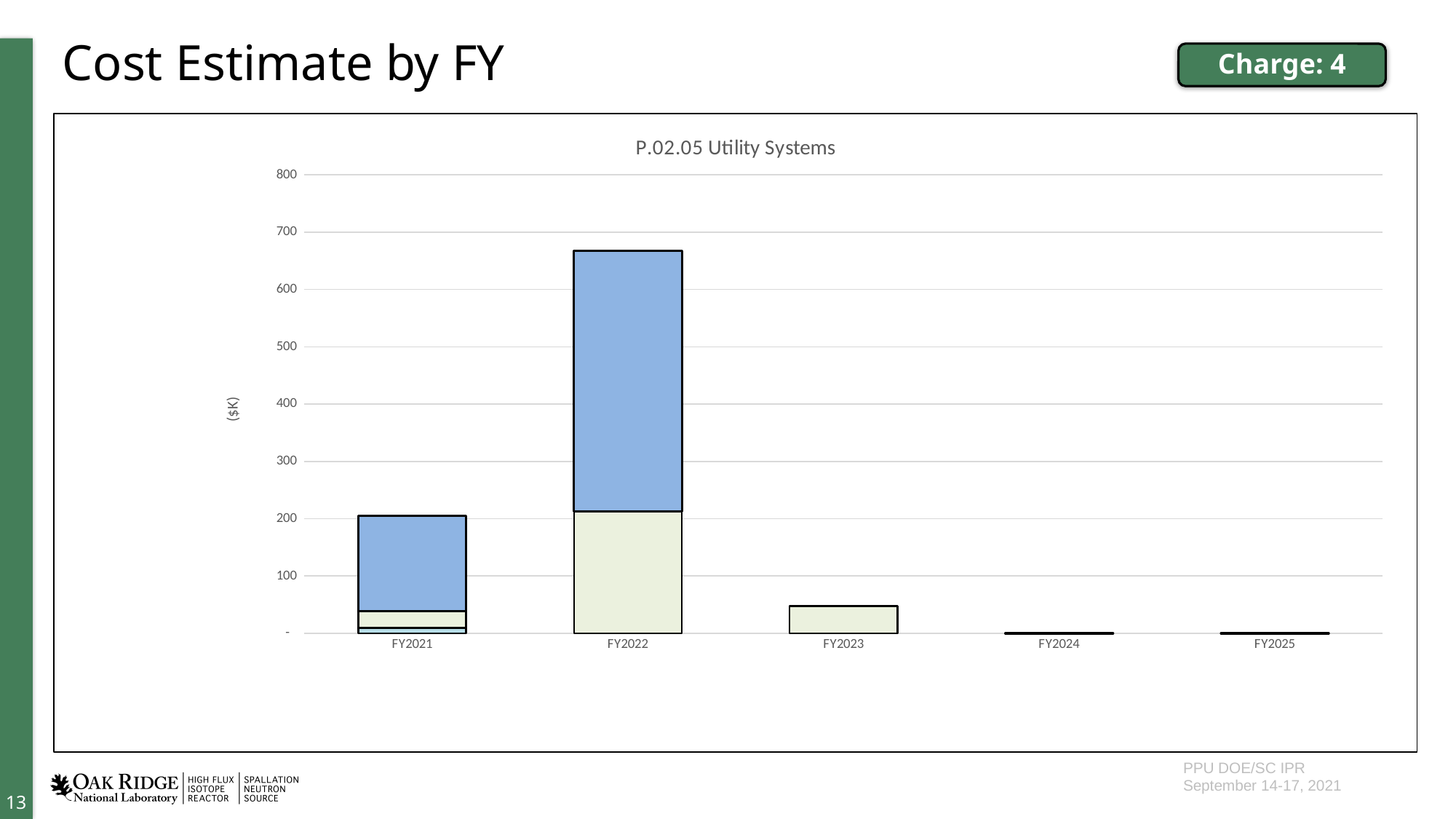
Is the value for FY2024 greater or less than 100? less How many fiscal years are shown on the x axis of the chart? 5 Do the total values rise or fall from FY2022 to FY2025? fall Is the total value for FY2022 greater or less than 600? greater Is the total value for FY2021 greater or less than 300? less What is the label on the vertical axis of the chart? ($K) Which fiscal year has the highest total cost estimate? FY2022 Which has the larger total cost estimate, FY2021 or FY2023? FY2021 Which has the larger total cost estimate, FY2021 or FY2022? FY2022 What kind of chart is shown on the slide? Stacked bar chart What is the title of the chart? P.02.05 Utility Systems